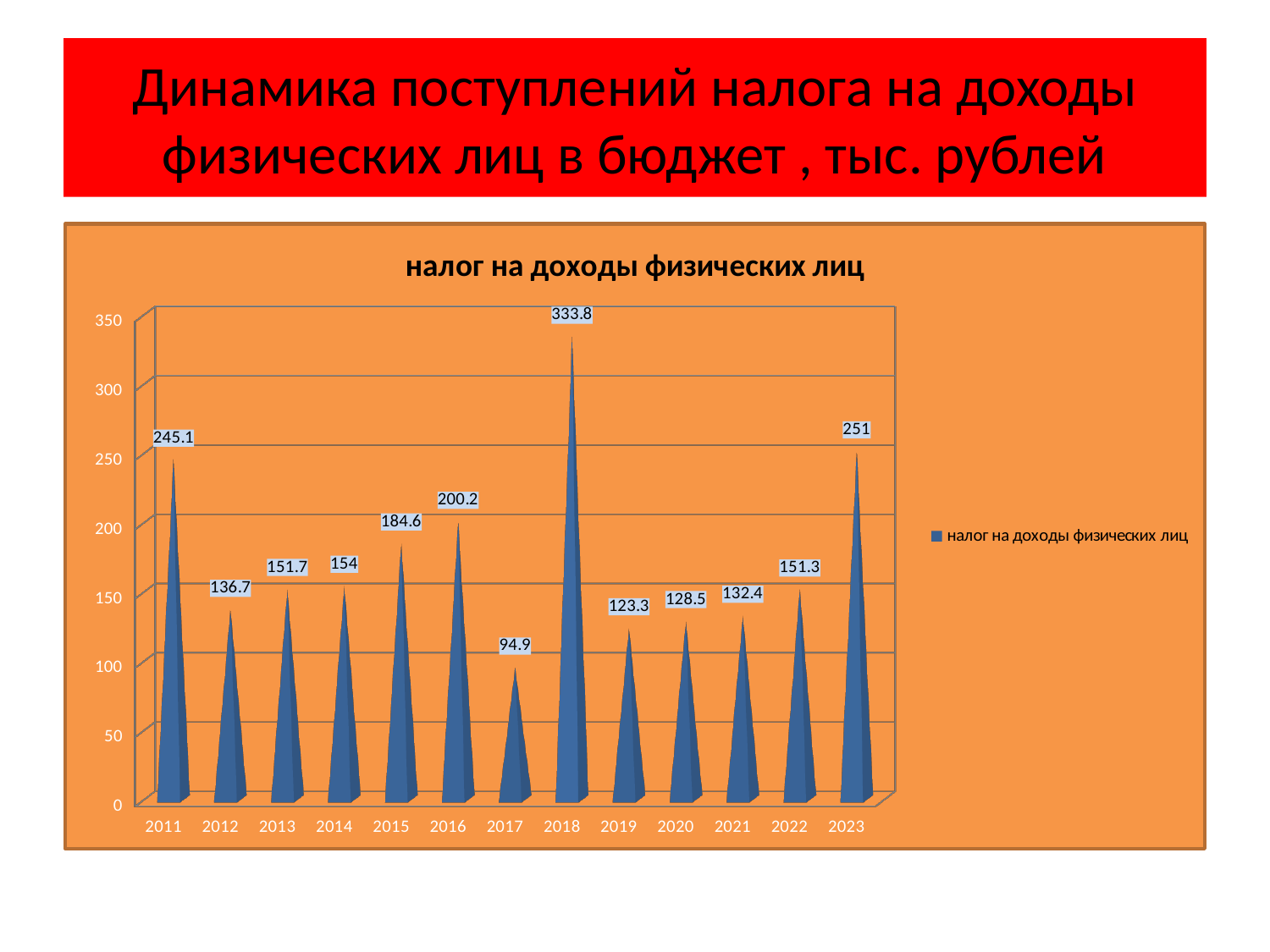
What is the title of the chart? налог на доходы физических лиц What kind of chart is shown? bar chart What is the value for 2017? 94.9 Which year has the highest value? 2018 Which year has the lowest value? 2017 What is the difference between the values for 2018 and 2023? 82.8 What is the value for 2018? 333.8 What is the value for 2023? 251 How many series does the legend list? 1 Which is larger, the value for 2011 or the value for 2016? 2011 Is the value for 2015 greater or less than 150? greater How many years are shown on the x axis? 13